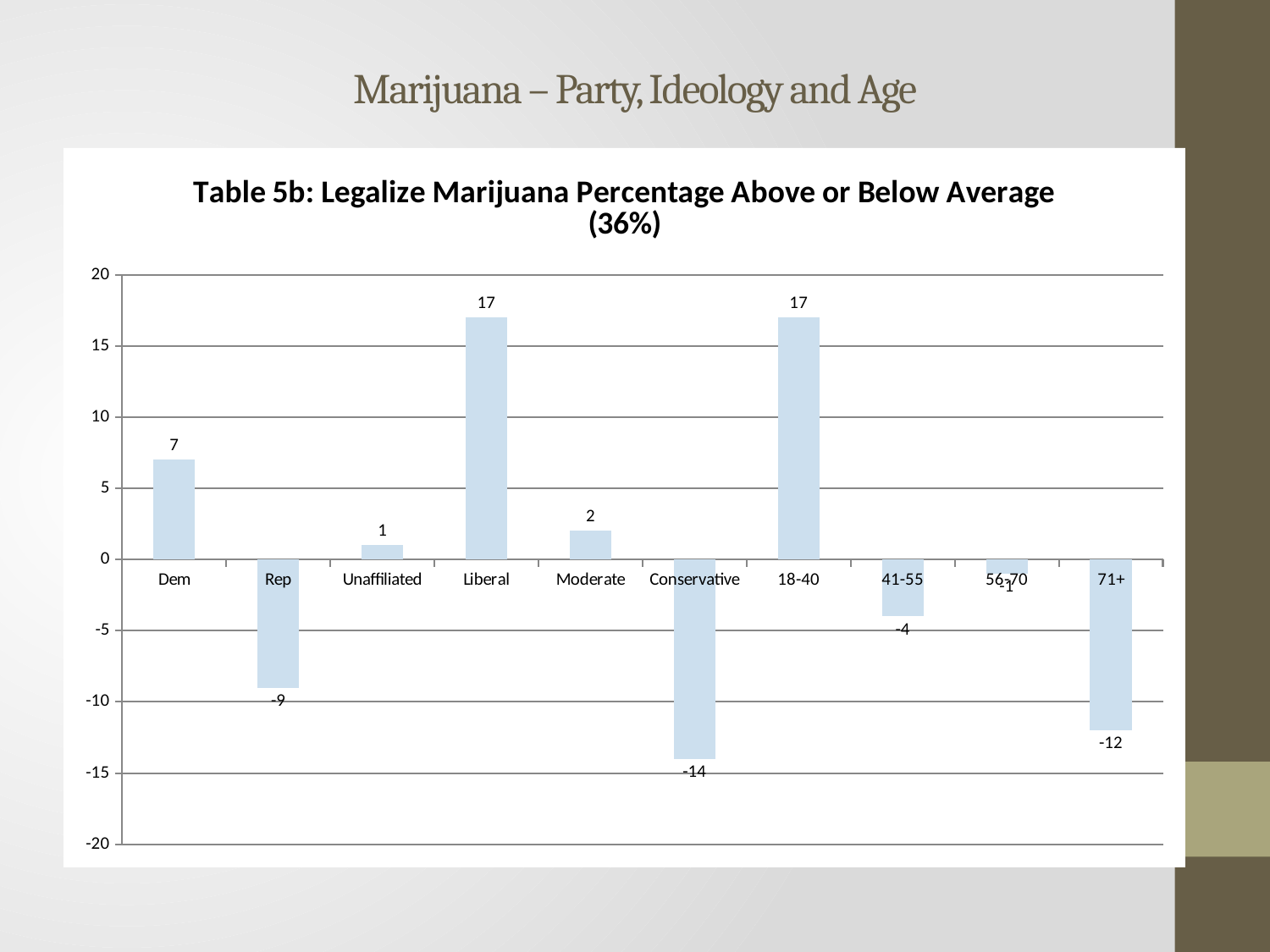
Which is larger, the value for Dem or the value for Unaffiliated? Dem What is the value for Dem? 7 What kind of chart is this? Bar chart What average percentage is stated in the chart title? 36% Which is lower, the value for 41-55 or the value for 71+? 71+ What is the value for Moderate? 2 Which category has the lowest value? Conservative What is the difference between the values for Rep and Conservative? 5 How many categories are shown on the x axis? 10 What is the value for Conservative? -14 What is the value for 71+? -12 What is the difference between the values for Liberal and Dem? 10